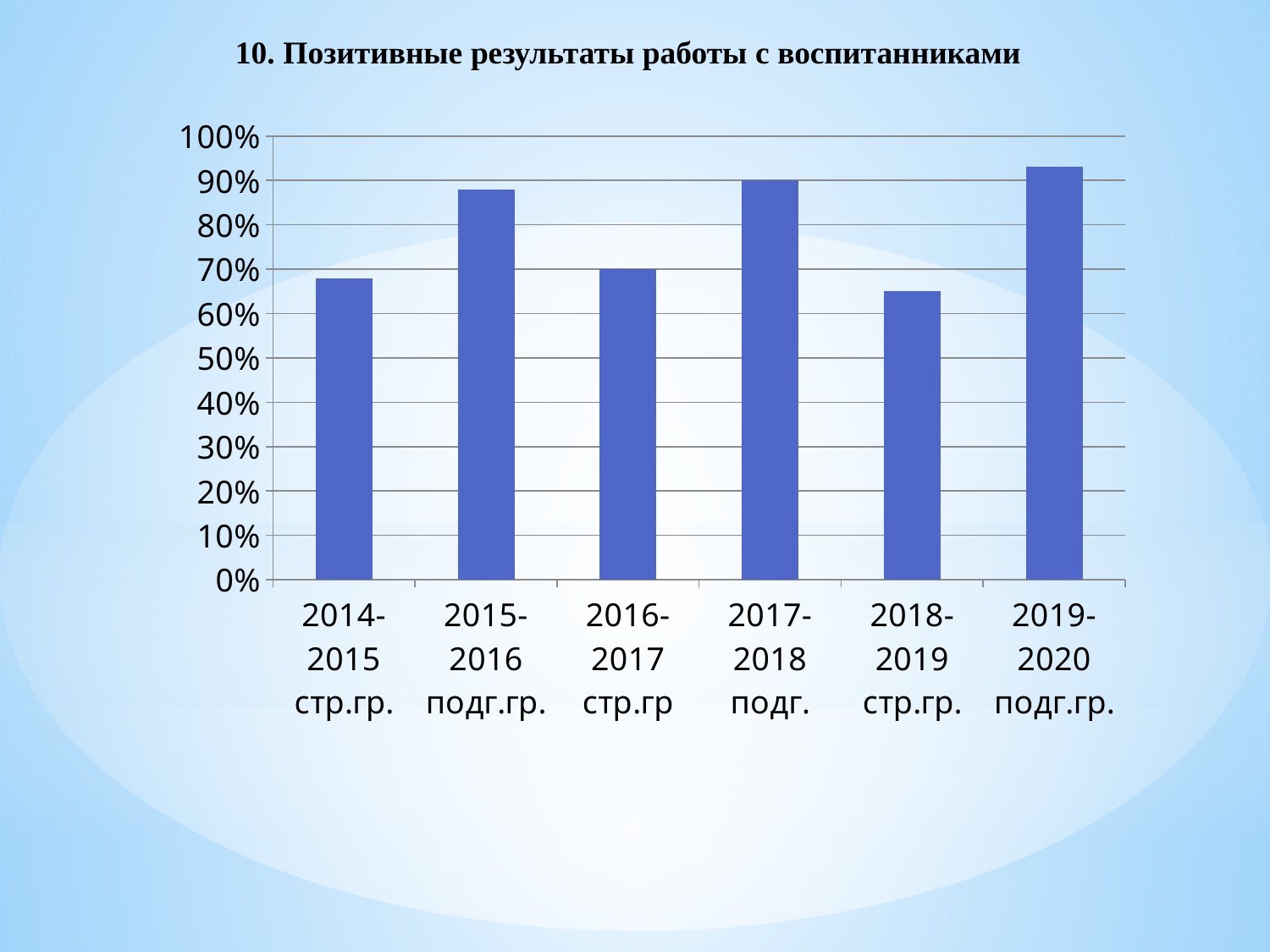
Does the value rise or fall from 2018-2019 стр.гр. to 2019-2020 подг.гр.? rise Is the value for 2019-2020 подг.гр. greater or less than 90%? greater Is the value for 2018-2019 стр.гр. greater or less than 70%? less Which category has the highest value in the chart? 2019-2020 подг.гр. What type of chart is shown on the slide? bar chart Which is larger, the value for 2017-2018 подг. or the value for 2016-2017 стр.гр? 2017-2018 подг. What is the title of the slide above the chart? 10. Позитивные результаты работы с воспитанниками How many categories (bars) are shown in the chart? 6 Is the value for 2014-2015 стр.гр. greater or less than 70%? less Which is larger, the value for 2015-2016 подг.гр. or the value for 2014-2015 стр.гр.? 2015-2016 подг.гр. What is the value for 2017-2018 подг.? 90%